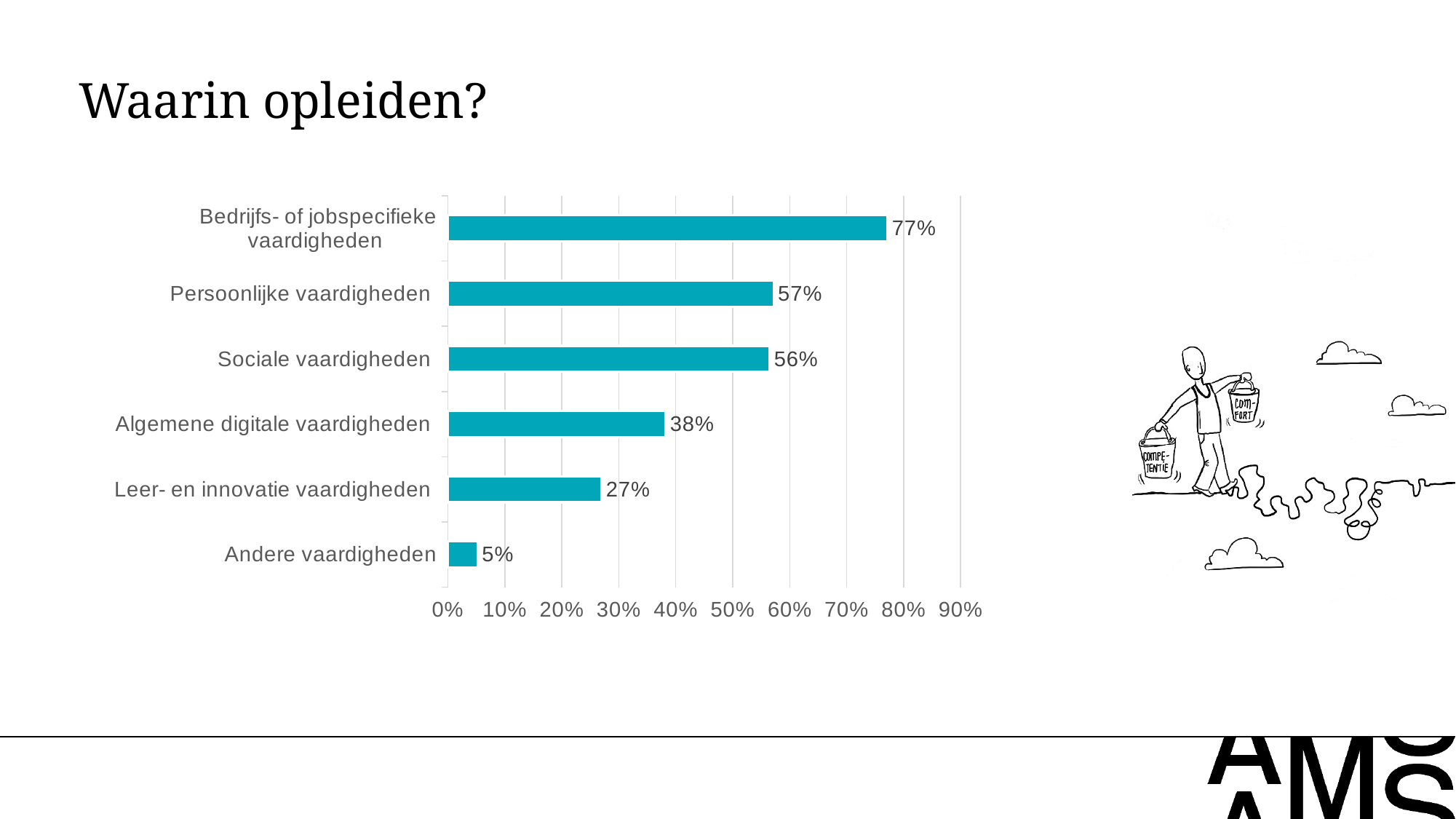
What is the value for Algemene digitale vaardigheden? 38% What is the difference between Algemene digitale vaardigheden and Leer- en innovatie vaardigheden? 11% What is the value for Leer- en innovatie vaardigheden? 27% What is the value for Bedrijfs- of jobspecifieke vaardigheden? 77% What is the title of the slide? Waarin opleiden? How many categories are shown in the chart? 6 What kind of chart is shown on the slide? bar chart Is the value for Leer- en innovatie vaardigheden greater or less than 30%? less Which category has the highest value? Bedrijfs- of jobspecifieke vaardigheden What is the difference between Bedrijfs- of jobspecifieke vaardigheden and Persoonlijke vaardigheden? 20% Which category has the lowest value? Andere vaardigheden Which is larger: Sociale vaardigheden or Algemene digitale vaardigheden? Sociale vaardigheden